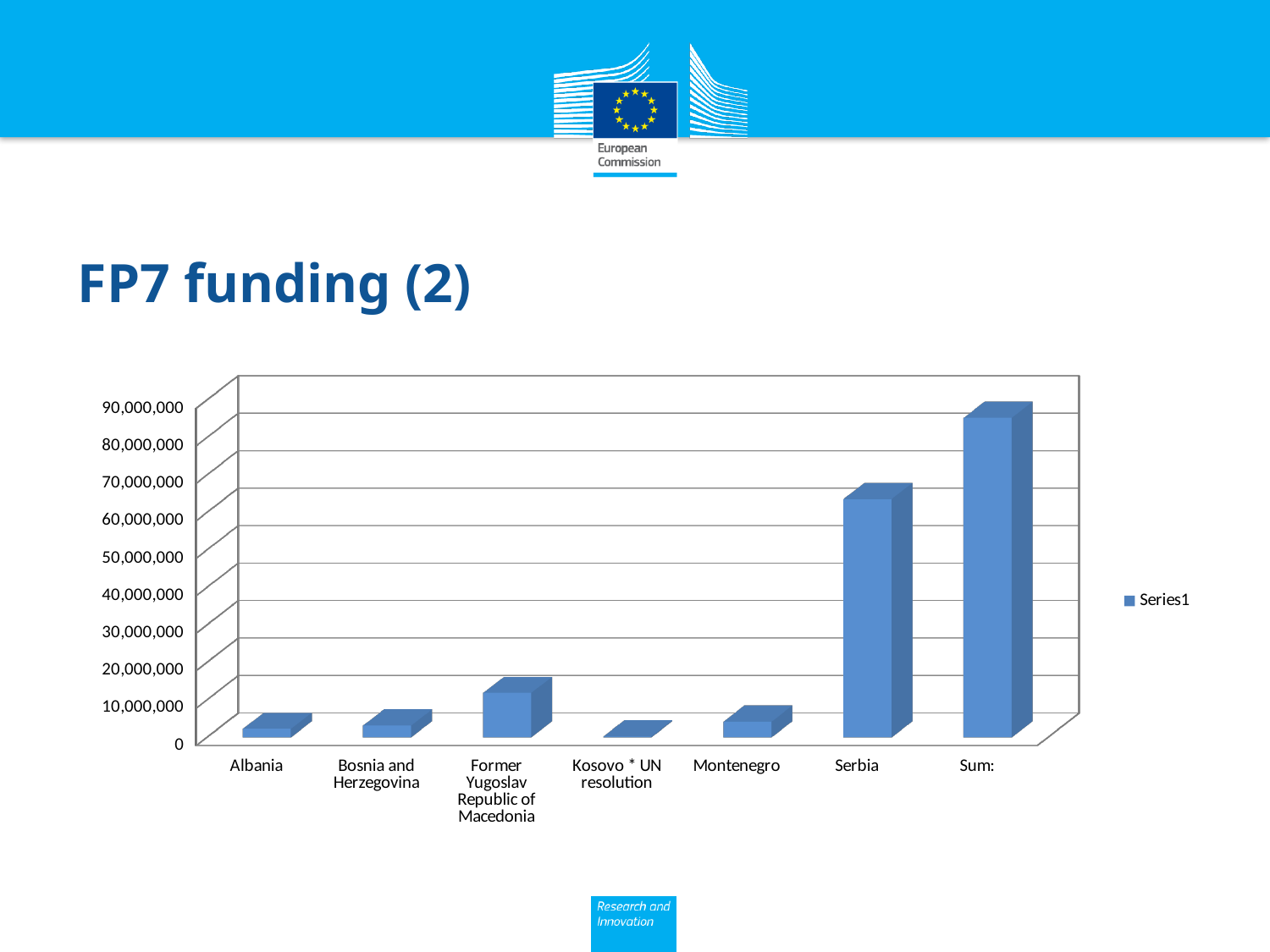
Which category has the lowest bar in the chart? Kosovo * UN resolution Which is larger, the value for Serbia or the value for Former Yugoslav Republic of Macedonia? Serbia What kind of chart is shown on the slide? bar chart Is the value for Albania greater or less than 10,000,000? less How many categories are shown on the x axis of the chart? 7 Is the value for Former Yugoslav Republic of Macedonia greater or less than 20,000,000? less What is the title of the slide containing the chart? FP7 funding (2) Is the value for Sum: greater or less than 80,000,000? greater Which country (excluding the Sum: bar) has the highest value in the chart? Serbia Which category has the highest bar in the chart? Sum: How many series does the chart's legend list? 1